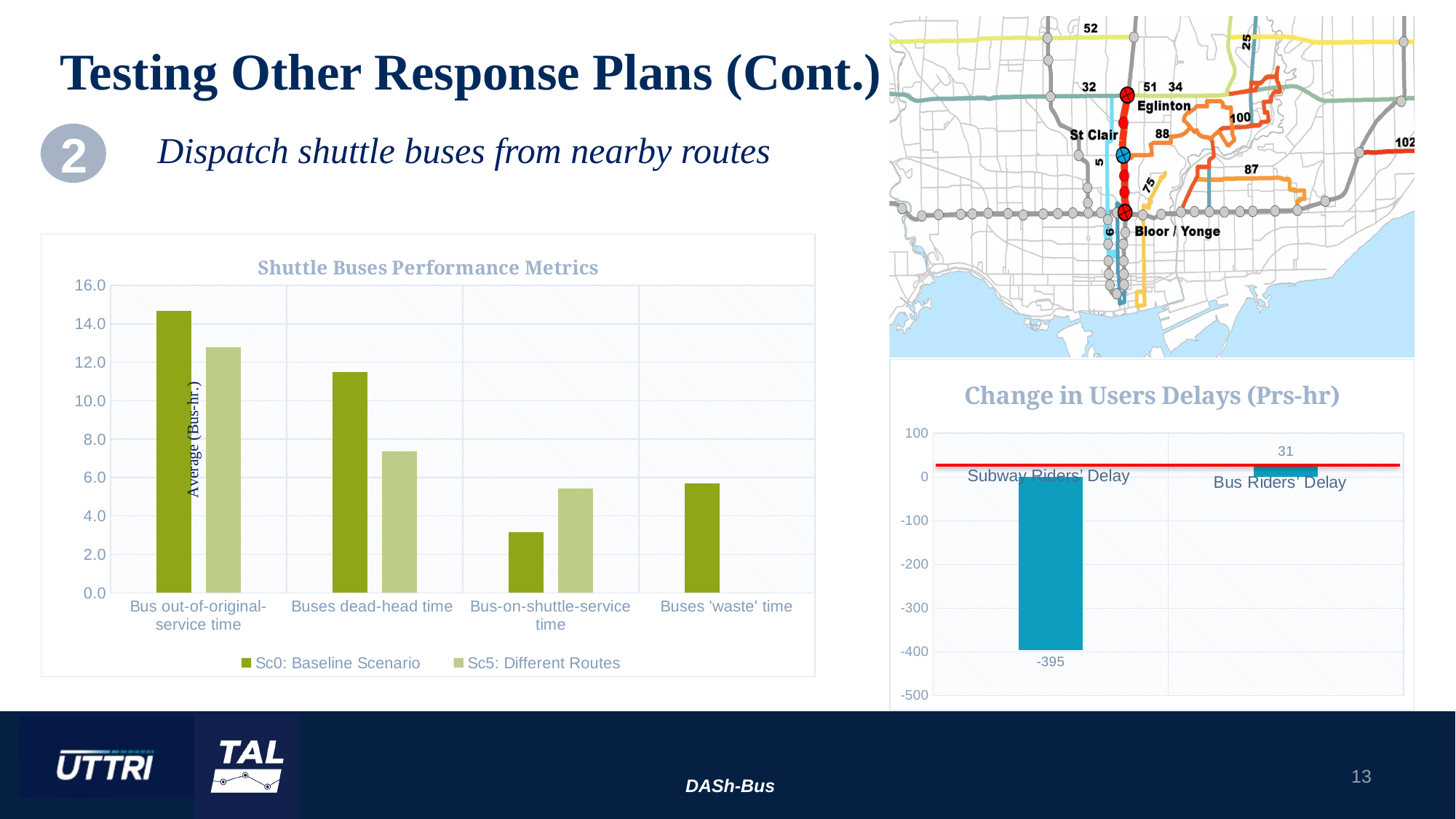
In the 'Shuttle Buses Performance Metrics' chart, is the Sc5: Different Routes value for Bus-on-shuttle-service time greater or less than 4.0? greater In the 'Shuttle Buses Performance Metrics' chart, for Bus-on-shuttle-service time, which series has the larger value: Sc0: Baseline Scenario or Sc5: Different Routes? Sc5: Different Routes In the 'Change in Users Delays (Prs-hr)' chart, what is the value for Bus Riders' Delay? 31 What type of chart is the 'Shuttle Buses Performance Metrics' chart? bar chart In the 'Change in Users Delays (Prs-hr)' chart, what is the difference between the Bus Riders' Delay value and the Subway Riders' Delay value? 426 In the 'Change in Users Delays (Prs-hr)' chart, what is the value for Subway Riders' Delay? -395 How many categories are shown on the x axis of the 'Shuttle Buses Performance Metrics' chart? 4 In the 'Shuttle Buses Performance Metrics' chart, which category has the lowest value for Sc0: Baseline Scenario? Bus-on-shuttle-service time In the 'Shuttle Buses Performance Metrics' chart, which category has the highest value for Sc0: Baseline Scenario? Bus out-of-original-service time In the 'Shuttle Buses Performance Metrics' chart, for Buses dead-head time, which series has the larger value: Sc0: Baseline Scenario or Sc5: Different Routes? Sc0: Baseline Scenario How many series does the legend of the 'Shuttle Buses Performance Metrics' chart list? 2 In the 'Shuttle Buses Performance Metrics' chart, is the Sc0: Baseline Scenario value for Buses dead-head time greater or less than 10.0? greater